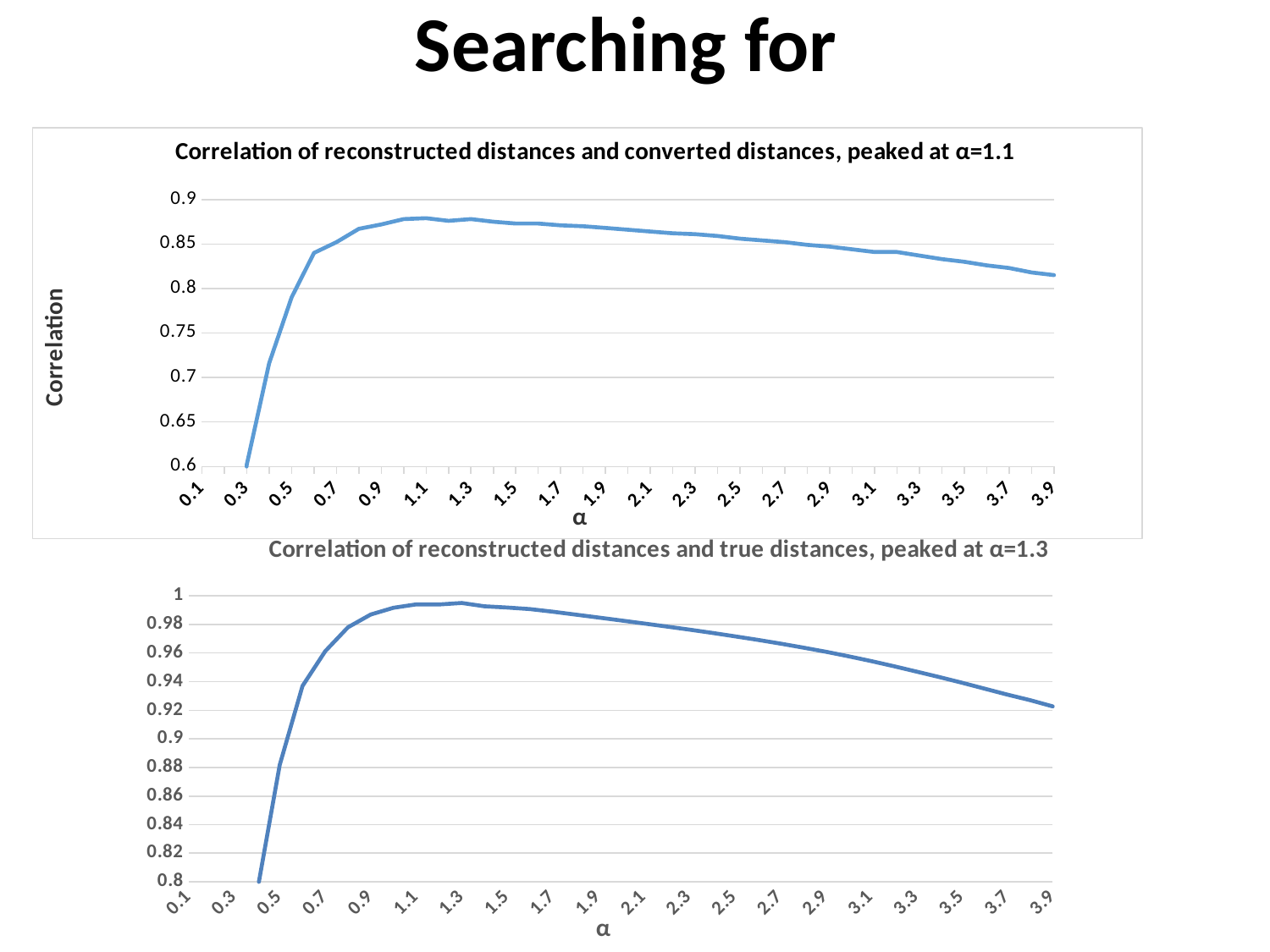
In the bottom chart, do the correlation values rise or fall as α increases from 0.5 to 1.3? rise In the top chart, which has the larger correlation: α=0.9 or α=3.9? α=0.9 What is the label of the y axis of the top chart? Correlation What kind of chart is the top chart, titled 'Correlation of reconstructed distances and converted distances, peaked at α=1.1'? line chart What kind of chart is the bottom chart, titled 'Correlation of reconstructed distances and true distances, peaked at α=1.3'? line chart In the top chart, is the correlation at α=3.9 greater or less than 0.85? less In the top chart, is the correlation at α=0.9 greater or less than 0.85? greater In the bottom chart, is the correlation at α=0.7 greater or less than 0.94? greater In the top chart, at which value of α does the correlation peak? α=1.1 In the bottom chart, at which value of α does the correlation peak? α=1.3 In the top chart, do the correlation values rise or fall as α increases from 1.3 to 3.9? fall